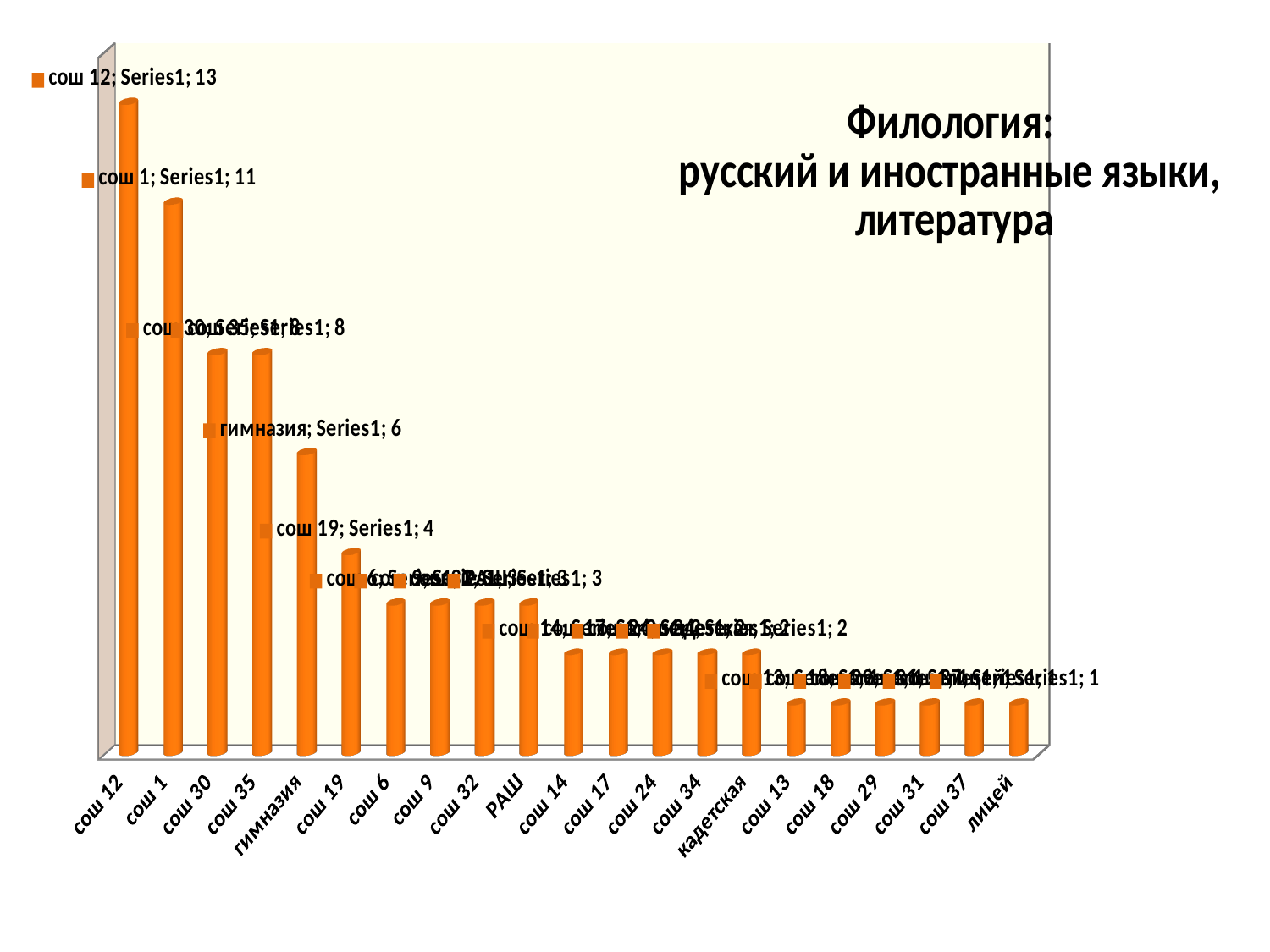
Which is larger, the value for сош 1 or the value for гимназия? сош 1 Which category has the highest value? сош 12 What is the difference between the values for гимназия and сош 19? 2 What is the value for сош 12? 13 What is the value for сош 19? 4 What is the value for гимназия? 6 What is the difference between the values for сош 12 and сош 1? 2 Which is larger, the value for сош 19 or the value for сош 30? сош 30 Do the values rise or fall from left to right along the x axis? fall What is the value for сош 1? 11 How many categories are shown on the x axis? 21 What kind of chart is shown on the slide? bar chart